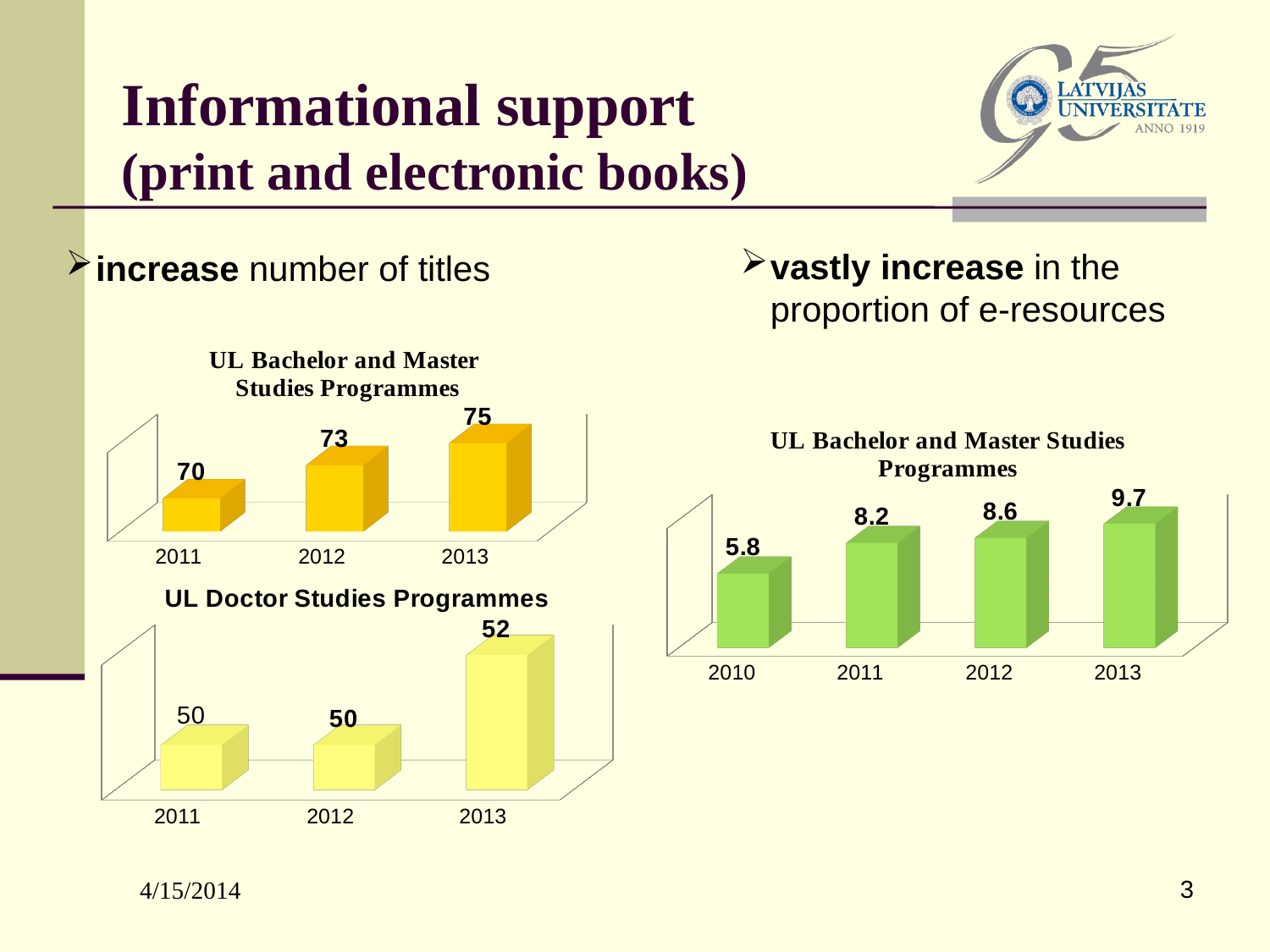
In the right-hand chart (UL Bachelor and Master Studies Programmes, green bars), which is larger, the value for 2011 or 2012? 2012 In the top-left chart (UL Bachelor and Master Studies Programmes, orange bars), which year has the highest value? 2013 In the bottom-left chart (UL Doctor Studies Programmes), what is the value for 2013? 52 In the right-hand chart (UL Bachelor and Master Studies Programmes, green bars), what is the value for 2010? 5.8 In the top-left chart (UL Bachelor and Master Studies Programmes, orange bars), what is the difference between the 2013 and 2011 values? 5 What kind of chart is the bottom-left chart (UL Doctor Studies Programmes)? bar chart In the right-hand chart (UL Bachelor and Master Studies Programmes, green bars), which year has the lowest value? 2010 In the bottom-left chart (UL Doctor Studies Programmes), what is the difference between the 2013 and 2012 values? 2 In the bottom-left chart (UL Doctor Studies Programmes), how many years are shown? 3 In the right-hand chart (UL Bachelor and Master Studies Programmes, green bars), how many years are shown? 4 In the right-hand chart (UL Bachelor and Master Studies Programmes, green bars), do the values rise or fall from 2010 to 2013? rise In the top-left chart (UL Bachelor and Master Studies Programmes, orange bars), what is the value for 2012? 73